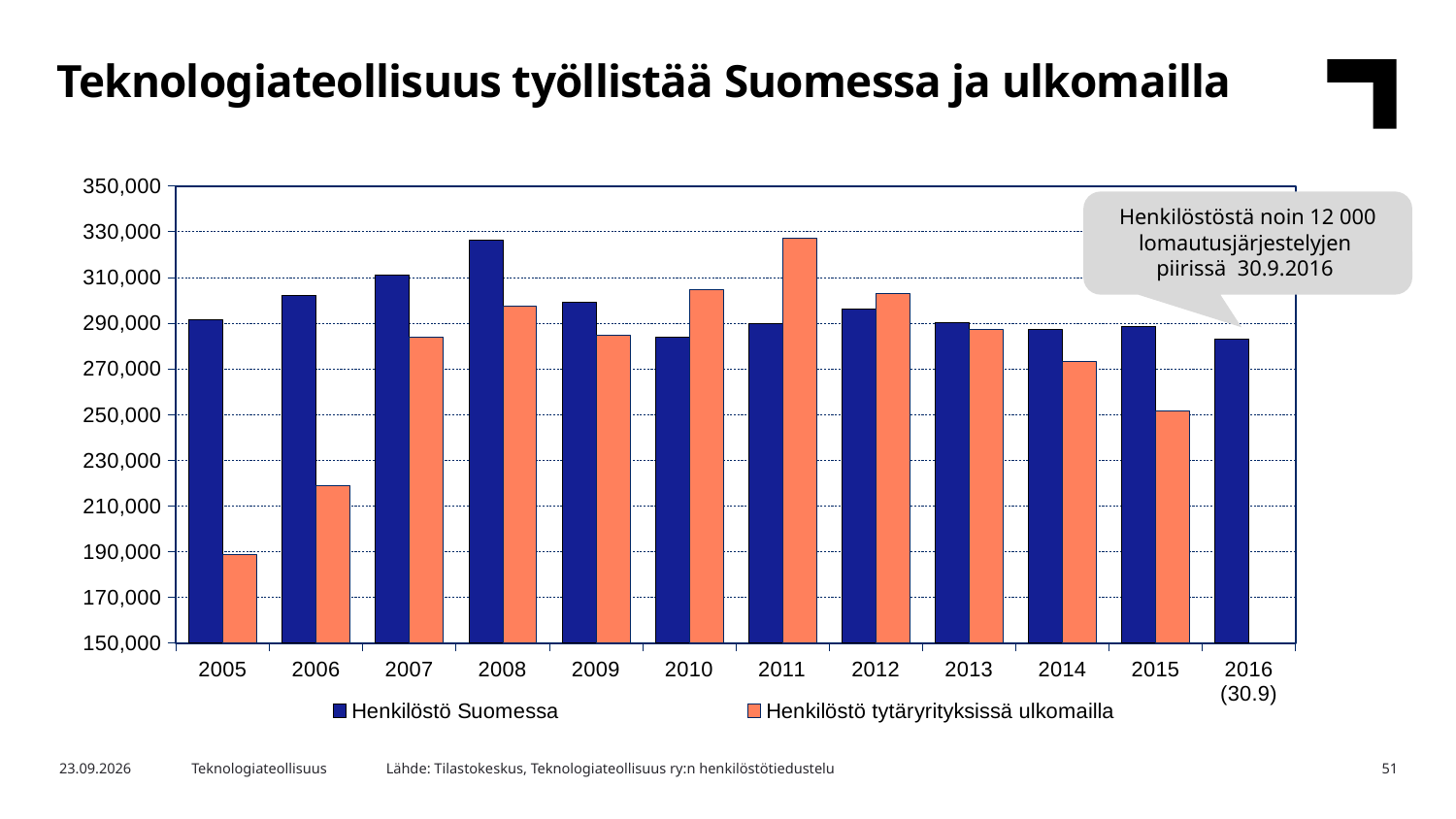
What kind of chart is shown on the slide? bar chart Is the value for Henkilöstö tytäryrityksissä ulkomailla in 2015 greater or less than 270,000? less Is the value for Henkilöstö Suomessa in 2008 greater or less than 310,000? greater In which year is the value for Henkilöstö Suomessa highest? 2008 In 2011, which is larger: Henkilöstö Suomessa or Henkilöstö tytäryrityksissä ulkomailla? Henkilöstö tytäryrityksissä ulkomailla Does the value for Henkilöstö tytäryrityksissä ulkomailla rise or fall from 2011 to 2015? fall In which year is the value for Henkilöstö tytäryrityksissä ulkomailla lowest? 2005 How many years are shown on the x axis? 12 In 2005, which is larger: Henkilöstö Suomessa or Henkilöstö tytäryrityksissä ulkomailla? Henkilöstö Suomessa How many series does the legend list? 2 Is the value for Henkilöstö tytäryrityksissä ulkomailla in 2006 greater or less than 210,000? greater In which year is the value for Henkilöstö tytäryrityksissä ulkomailla highest? 2011